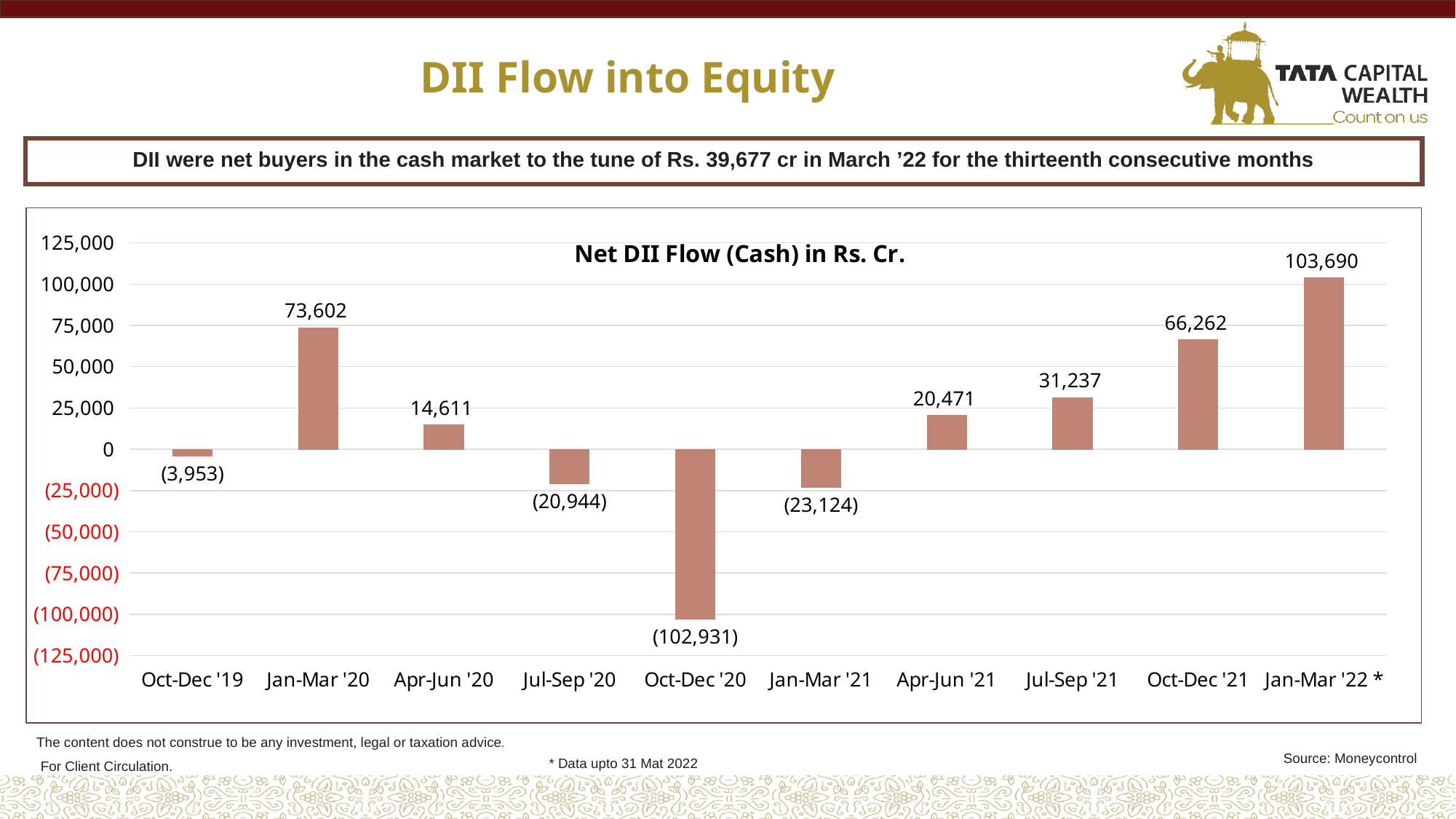
What is the Net DII Flow (Cash) value for Jan-Mar '20? 73,602 Which is larger, the Net DII Flow for Jan-Mar '20 or for Oct-Dec '21? Jan-Mar '20 What is the difference between the Net DII Flow values for Oct-Dec '21 and Jul-Sep '21? 35,025 What is the Net DII Flow (Cash) value for Oct-Dec '20? (102,931) What is the Net DII Flow (Cash) value for Apr-Jun '21? 20,471 How many quarters are shown on the x axis of the chart? 10 What is the Net DII Flow (Cash) value for Jan-Mar '22 *? 103,690 Do the Net DII Flow values rise or fall from Jan-Mar '21 to Jan-Mar '22 *? Rise Which quarter has the lowest Net DII Flow (Cash)? Oct-Dec '20 Which quarter has the highest Net DII Flow (Cash)? Jan-Mar '22 * What is the title of the chart on the slide? Net DII Flow (Cash) in Rs. Cr. What kind of chart is used to show Net DII Flow (Cash)? Bar chart